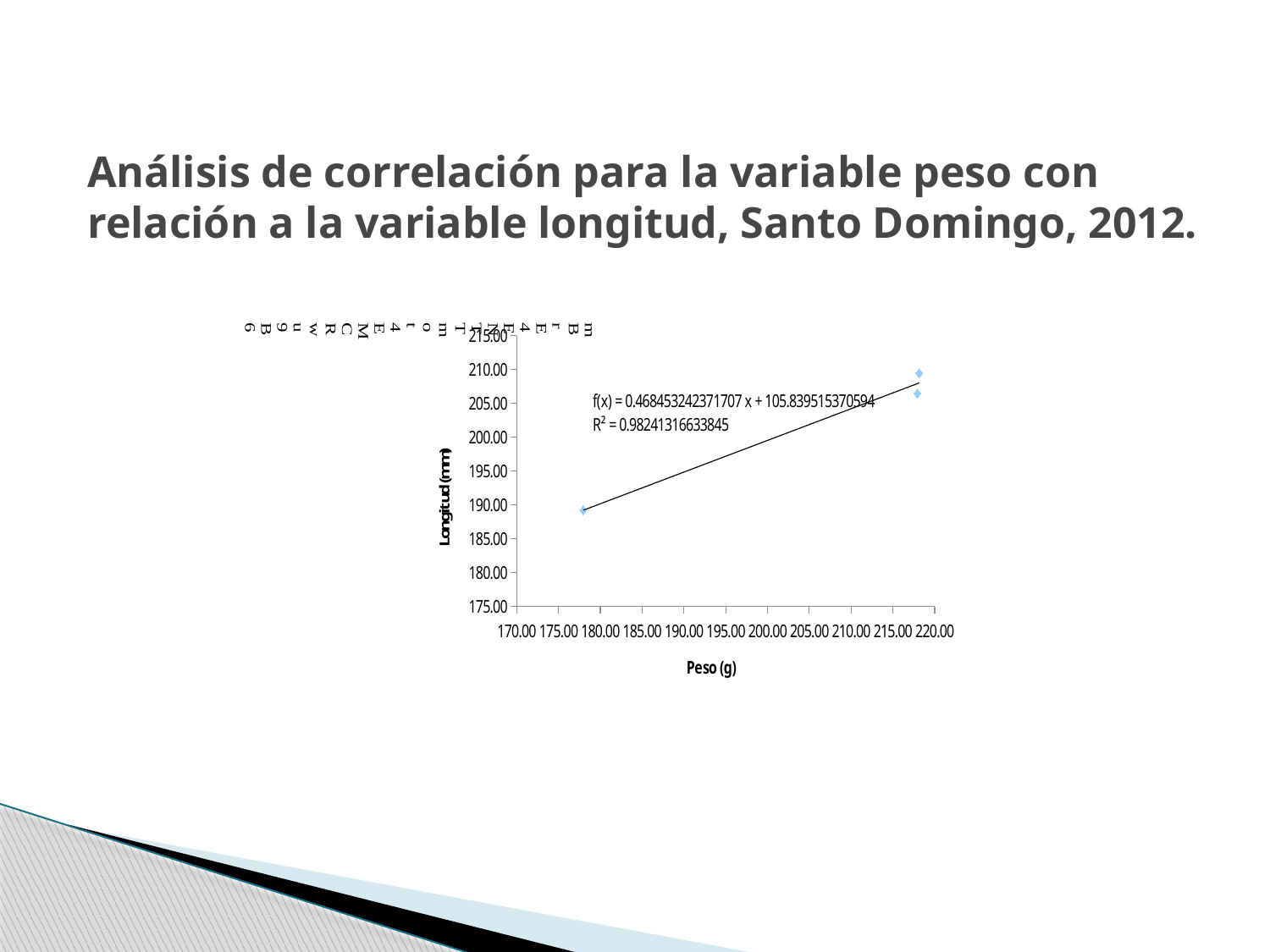
What is the title of the y axis? Longitud (mm) Do the plotted values of Longitud rise or fall as Peso increases along the x axis? Rise Is the Longitud value of the leftmost data point (near Peso 178) greater or less than 185.00? greater What is the title of the x axis? Peso (g) What is the highest tick value shown on the y axis? 215.00 Is the Peso value of the leftmost data point greater or less than 185.00? less How many data points are plotted on the chart? 3 What kind of chart is shown on the slide? Scatter chart What is the slope of the trendline shown on the chart? 0.468453242371707 What is the trendline equation shown on the chart? f(x) = 0.468453242371707 x + 105.839515370594 What is the R² value shown on the chart? R² = 0.98241316633845 Are the Longitud values of the two rightmost data points (near Peso 218) greater or less than 200.00? greater